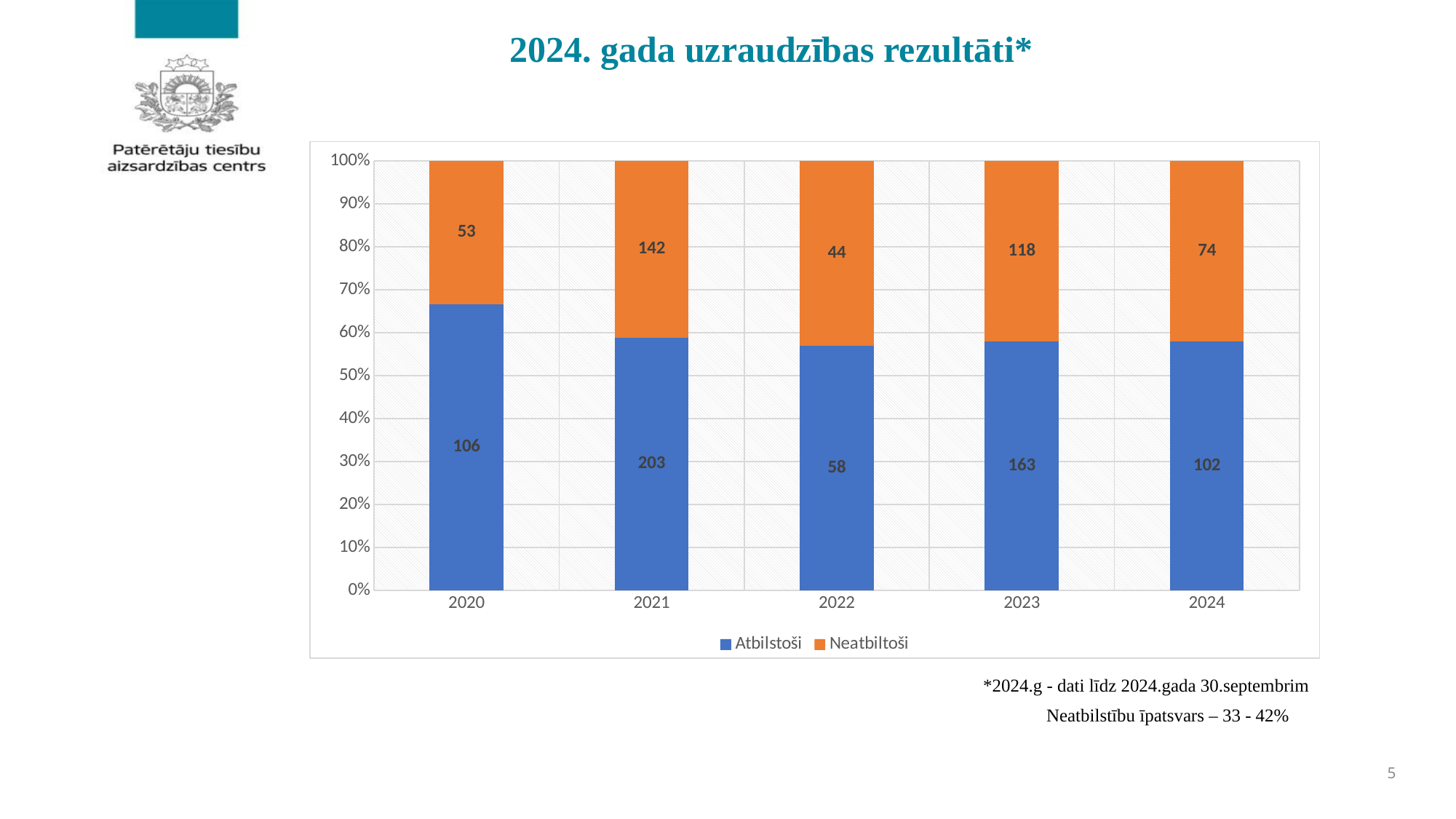
Which colour represents Neatbiltoši in the chart? Orange Which year has the lowest Neatbiltoši value? 2022 How many series does the legend list? 2 What is the total of the Atbilstoši and Neatbiltoši values for 2022? 102 What is the value for Atbilstoši in 2021? 203 What is the difference between the Atbilstoši and Neatbiltoši values in 2023? 45 How many years are shown on the x axis? 5 What is the value for Neatbiltoši in 2020? 53 What is the value for Neatbiltoši in 2024? 74 Which is larger, the Neatbiltoši value in 2021 or in 2023? 2021 Which year has the highest Atbilstoši value? 2021 What kind of chart is shown on the slide? Stacked bar chart